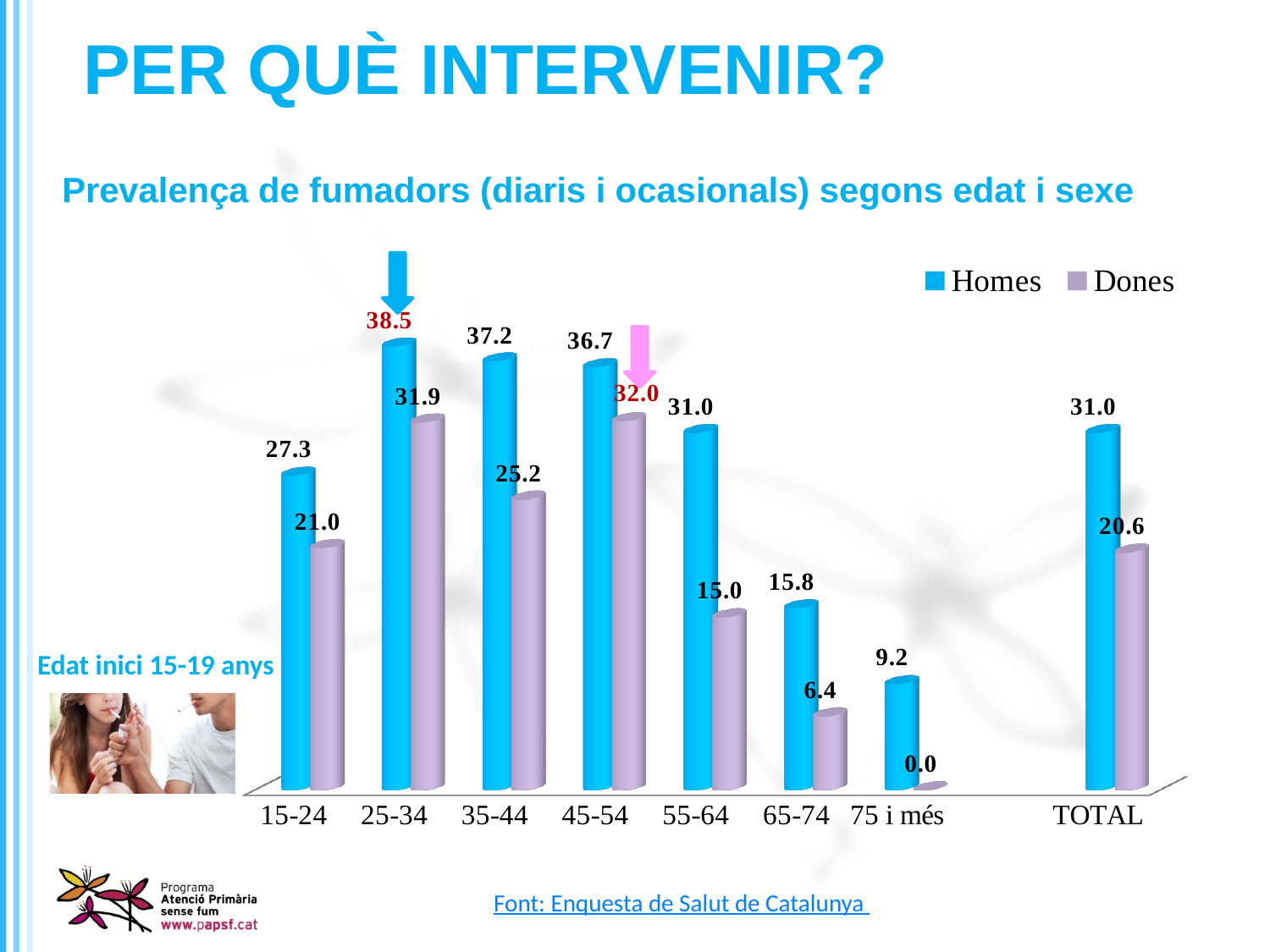
What is the difference between Homes and Dones in the 65-74 age group? 9.4 What is the value for Homes in the 25-34 age group? 38.5 What is the value for Dones in the 45-54 age group? 32.0 What kind of chart is shown on the slide? bar chart Do the Homes values rise or fall from the 45-54 age group to the 75 i més age group? fall Which colour represents the Dones series in the legend? purple How many series does the legend list? 2 Which age group has the lowest value for Dones? 75 i més Which is larger in the 35-44 age group, Homes or Dones? Homes What is the value for Dones in the TOTAL category? 20.6 Which age group has the highest value for Homes? 25-34 How many age categories (including TOTAL) are shown on the x axis? 8